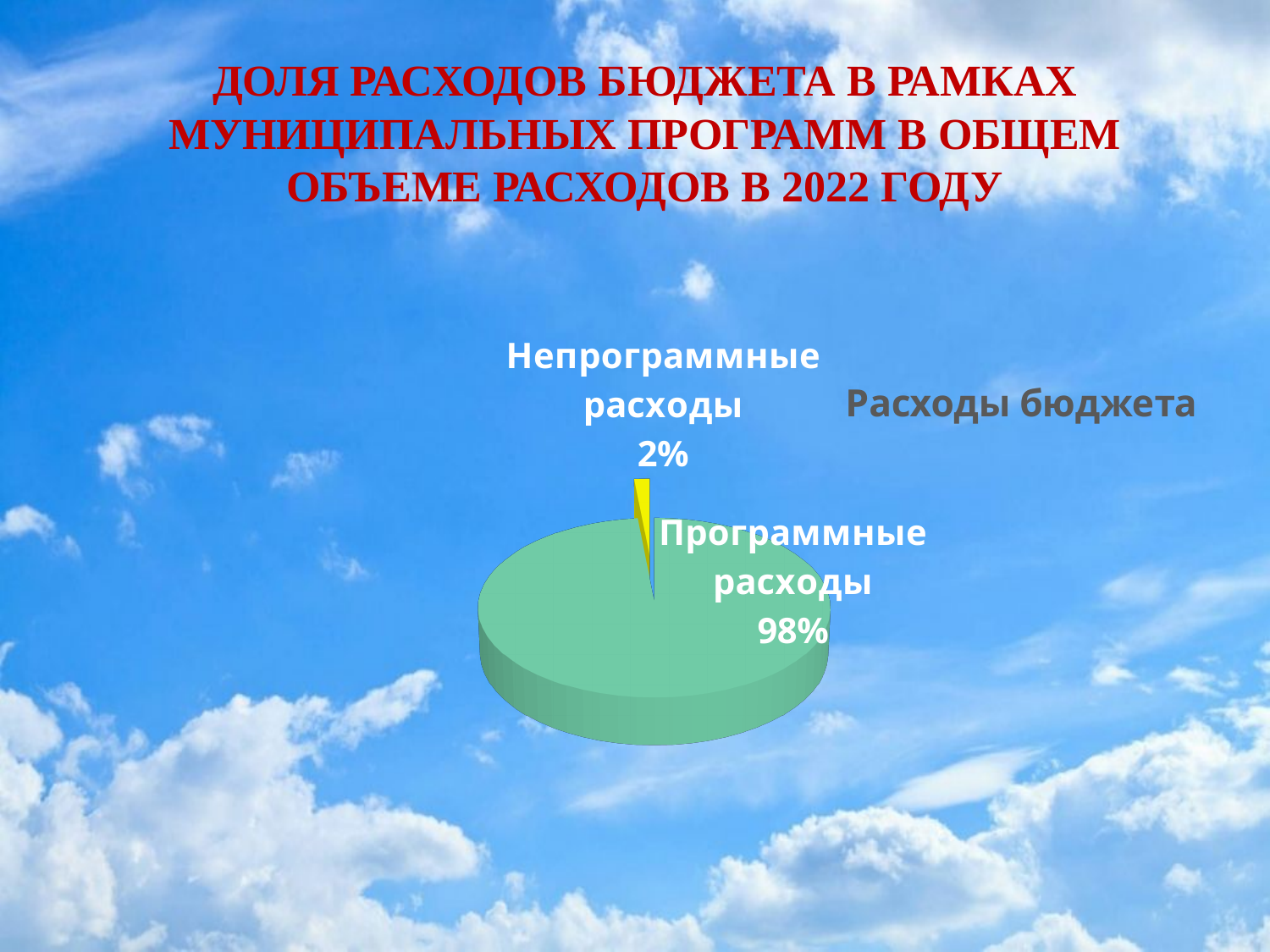
What share of the pie is labelled "Программные расходы"? 98% What is the difference in percentage points between "Программные расходы" and "Непрограммные расходы"? 96 Which slice of the pie is the largest? Программные расходы What colour is the slice for "Непрограммные расходы"? yellow Which is larger: the share for "Программные расходы" or for "Непрограммные расходы"? Программные расходы What share of the pie is labelled "Непрограммные расходы"? 2% Which slice of the pie is the smallest? Непрограммные расходы What is the title of the chart? Расходы бюджета What is the total of the two slice percentages shown on the pie? 100% How many slices does the pie chart have? 2 What kind of chart is shown on the slide? pie chart